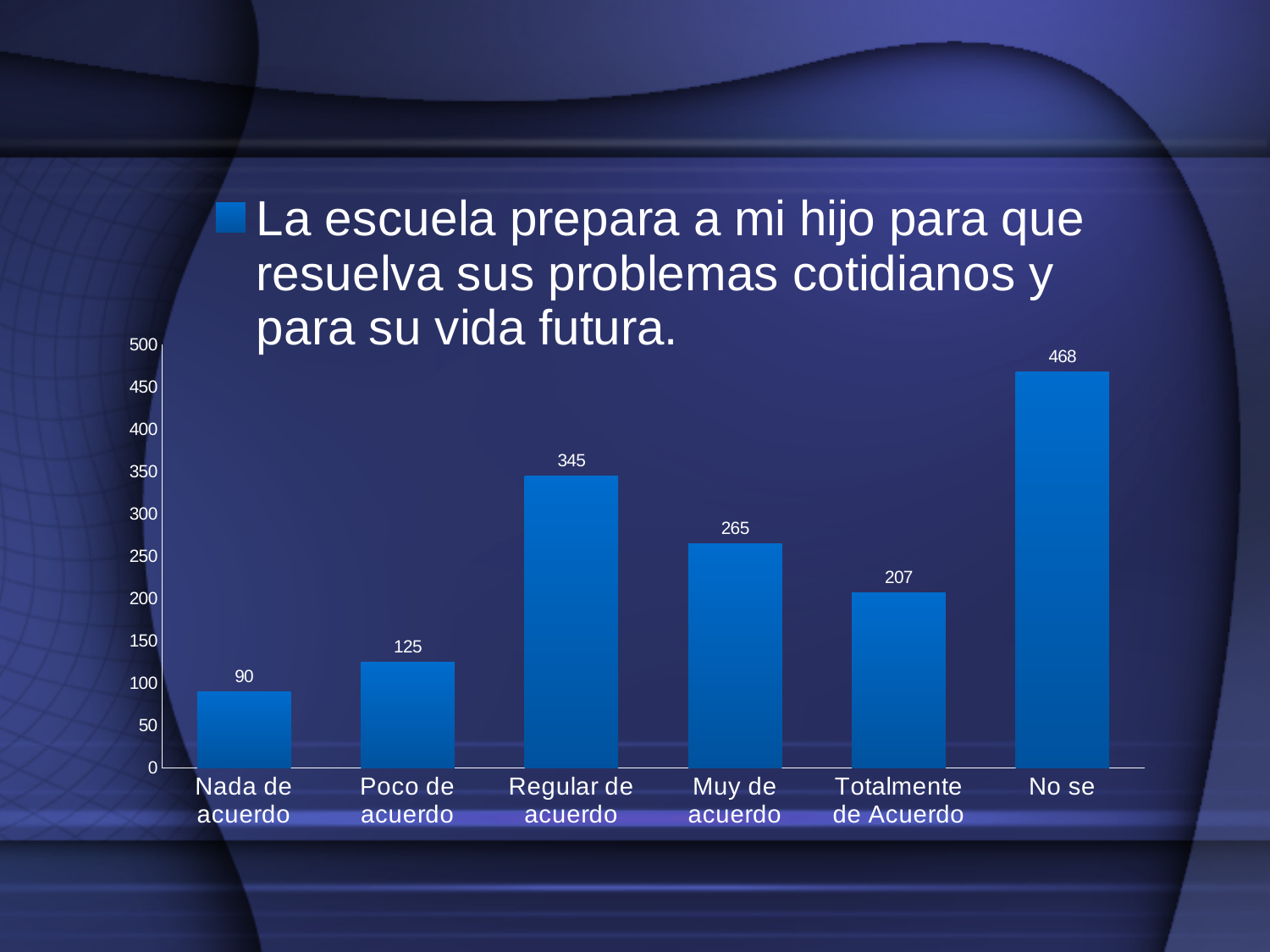
Which category has the lowest value? Nada de acuerdo How many categories are shown on the x axis? 6 What is the difference between the values for "No se" and "Regular de acuerdo"? 123 Which category has the highest value? No se What is the value for "No se"? 468 Which is larger, the value for "Muy de acuerdo" or the value for "Totalmente de Acuerdo"? Muy de acuerdo What kind of chart is shown on the slide? bar chart What is the difference between the values for "Muy de acuerdo" and "Poco de acuerdo"? 140 What is the maximum value shown on the y axis? 500 What is the value for "Regular de acuerdo"? 345 What is the value for "Totalmente de Acuerdo"? 207 Is the value for "Poco de acuerdo" greater or less than 150? less